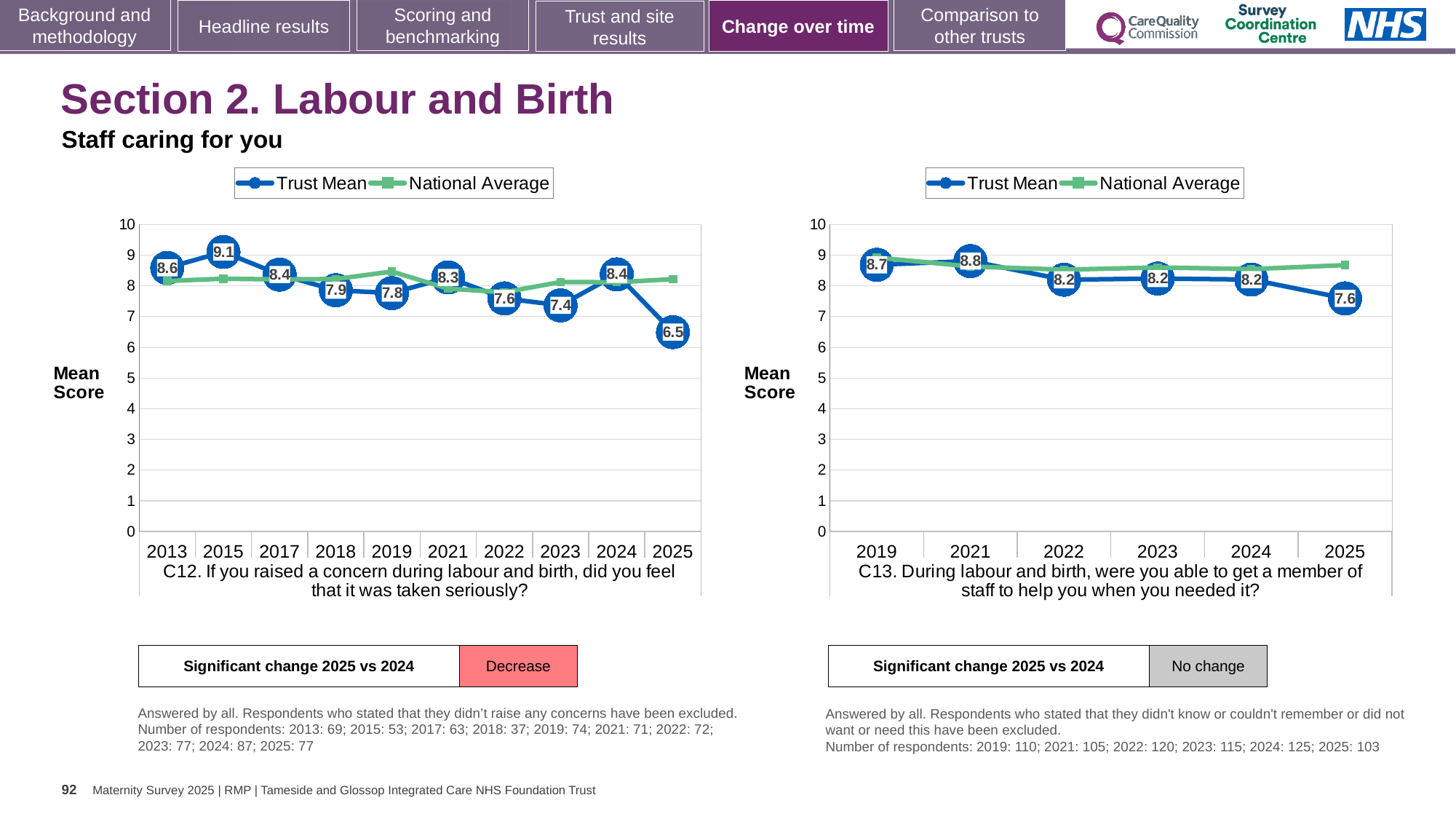
In the C12 chart, what is the Trust Mean for 2015? 9.1 In the C13 chart, what is the Trust Mean for 2021? 8.8 In the C12 chart, what is the difference between the Trust Mean for 2024 and 2025? 1.9 How many series does the legend of the C13 chart list? 2 In the C13 chart, is the Trust Mean for 2025 greater or less than the National Average for 2025? less In the C12 chart, what is the Trust Mean for 2025? 6.5 In the C12 chart, which year has the highest Trust Mean? 2015 In the C13 chart, what is the Trust Mean for 2025? 7.6 In the C13 chart, which year has the lowest Trust Mean? 2025 In the C12 chart, which year has the lowest Trust Mean? 2025 In the C12 chart, how many years are shown on the x axis? 10 What kind of chart is the C12 chart? line chart